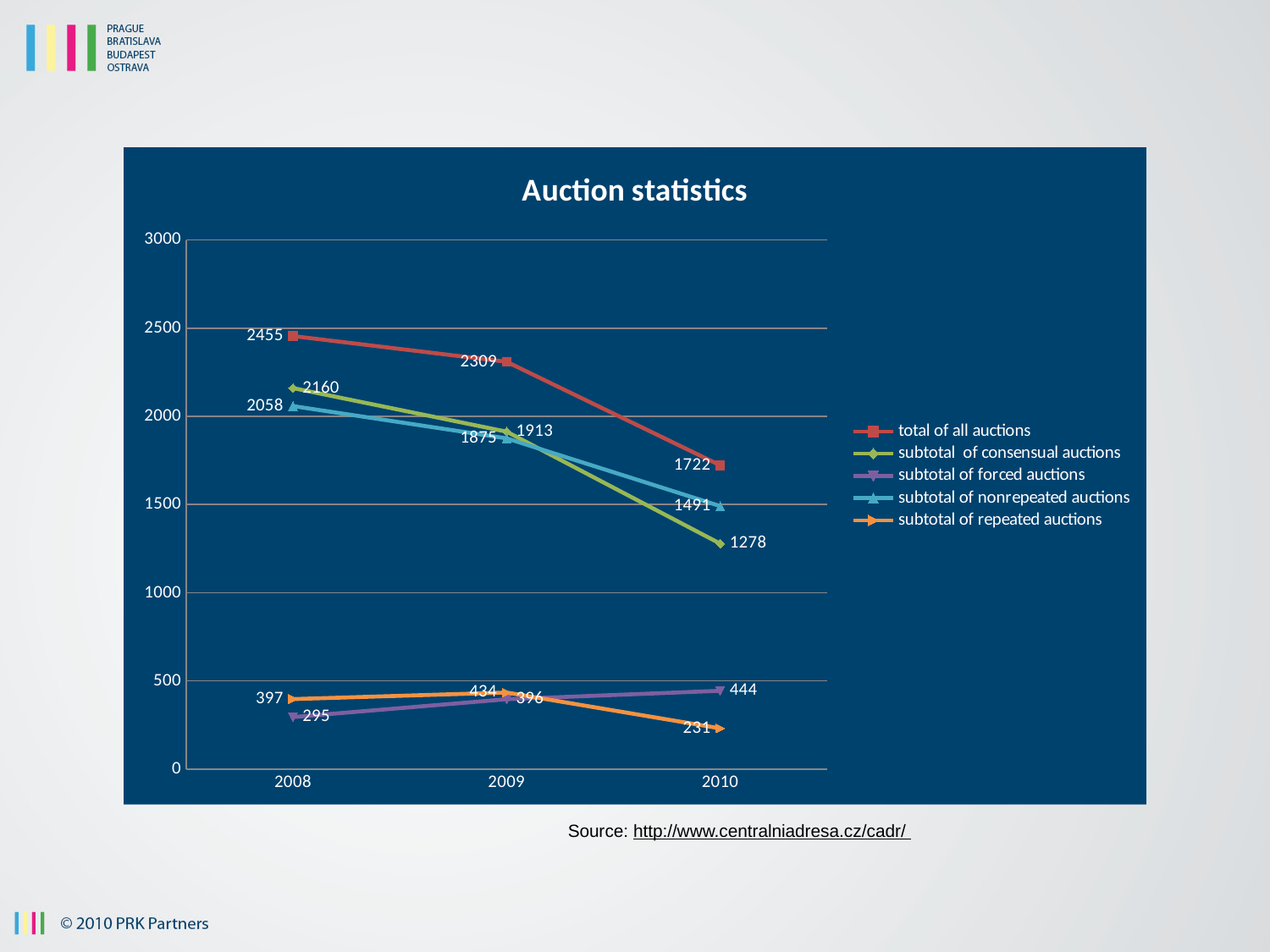
How many years are shown on the x axis? 3 What is the subtotal of forced auctions in 2009? 396 Does the total of all auctions rise or fall from 2008 to 2010? fall What is the title of the chart? Auction statistics In which year is the subtotal of forced auctions highest? 2010 Which is larger in 2010: the subtotal of nonrepeated auctions or the subtotal of consensual auctions? subtotal of nonrepeated auctions What is the total of all auctions in 2008? 2455 In which year is the subtotal of repeated auctions lowest? 2010 What type of chart is shown on the slide? line chart What is the subtotal of consensual auctions in 2010? 1278 By how much did the total of all auctions fall from 2009 to 2010? 587 How many series does the legend list? 5